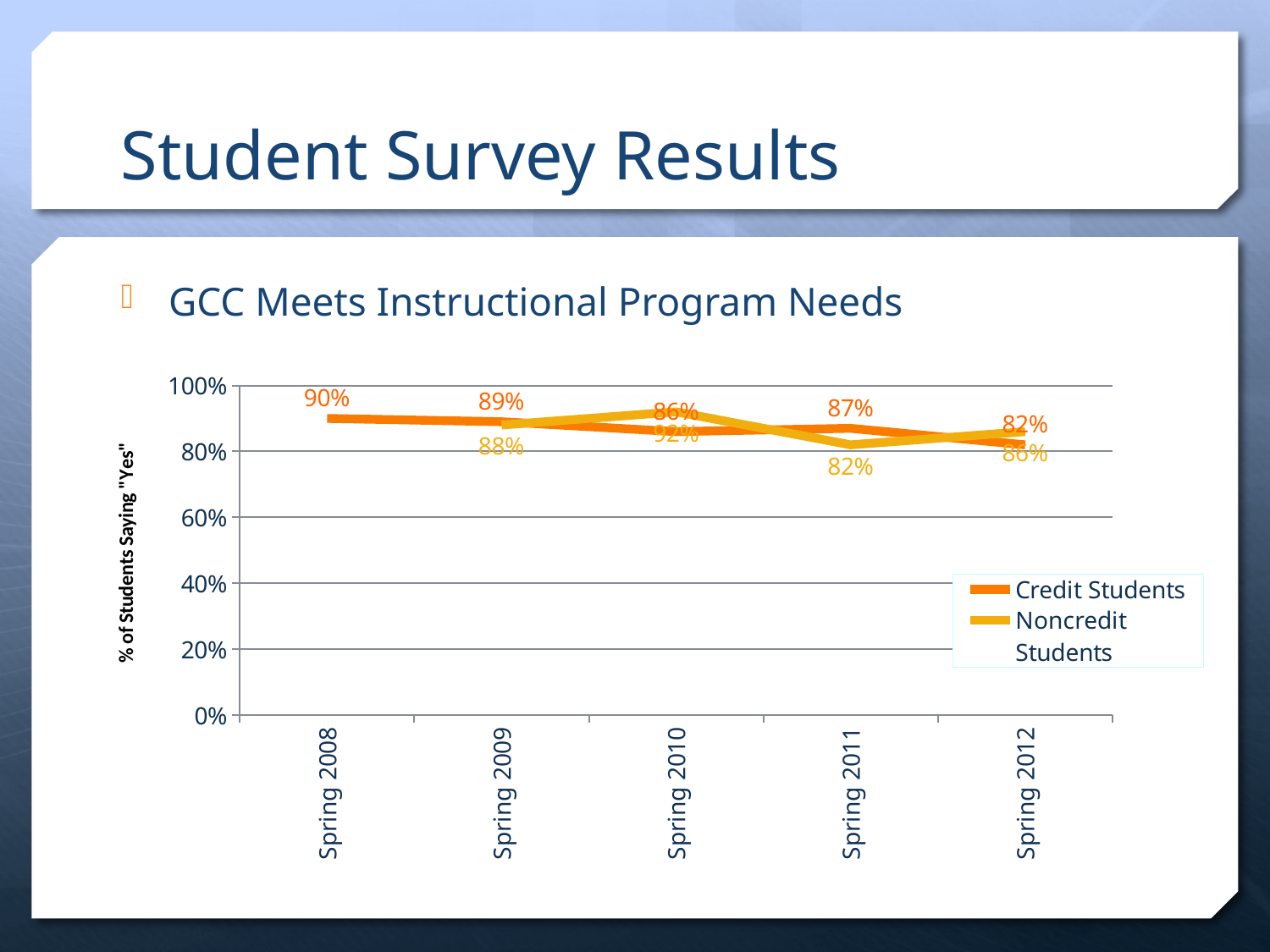
What is the value for Noncredit Students in Spring 2011? 82% How many series does the legend list? 2 What is the label on the vertical axis? % of Students Saying "Yes" What percentage of Credit Students said "Yes" in Spring 2012? 82% What type of chart is shown on the slide? Line chart What percentage of Credit Students said "Yes" in Spring 2008? 90% In which survey period was the Credit Students value highest? Spring 2008 How many survey periods are plotted along the x axis? 5 What is the value for Noncredit Students in Spring 2010? 92% In Spring 2010, which series has the larger value, Credit Students or Noncredit Students? Noncredit Students By how many percentage points did the Credit Students value fall from Spring 2008 to Spring 2012? 8 percentage points In which survey period was the Credit Students value lowest? Spring 2012